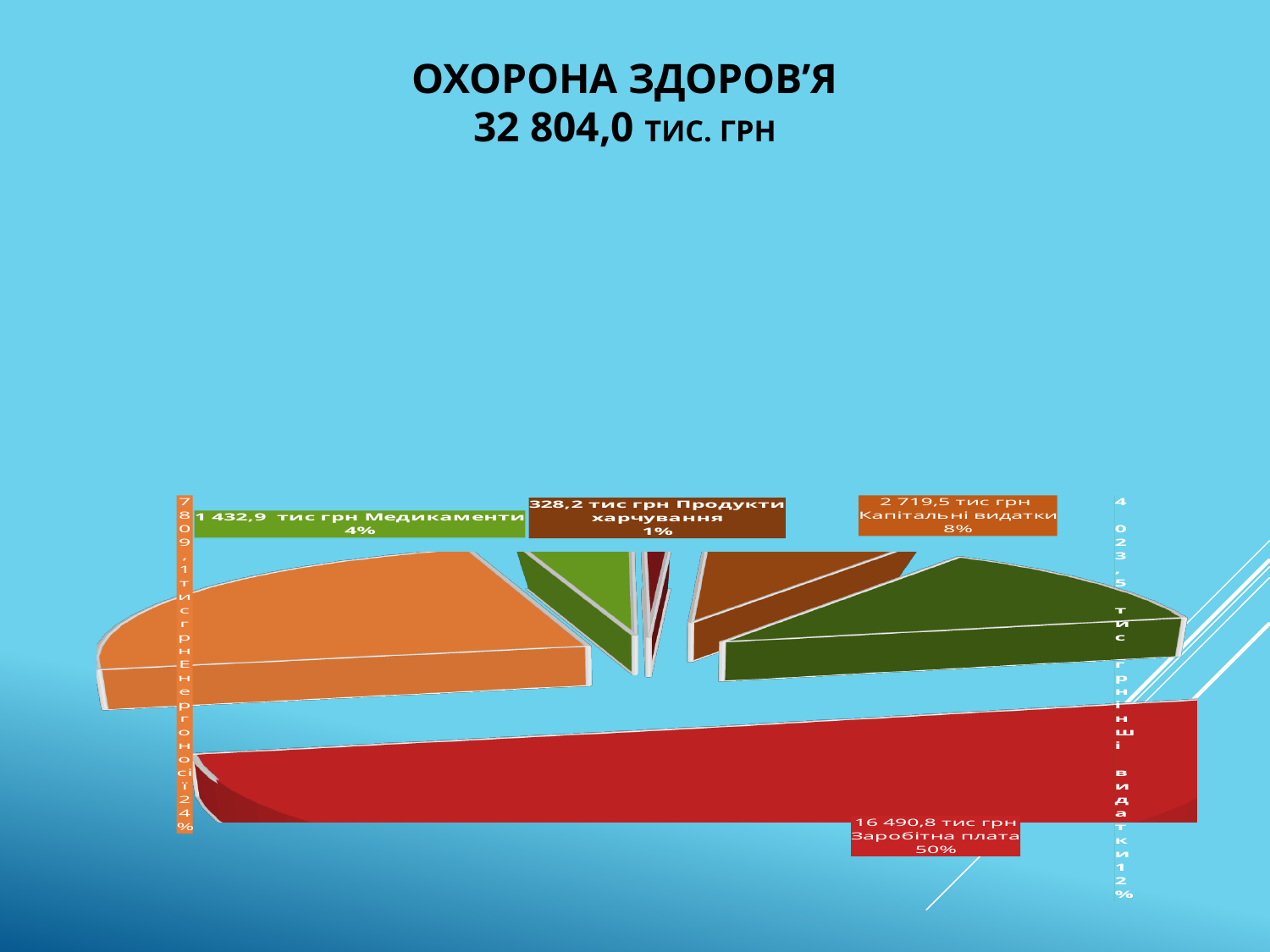
How many slices does the pie chart have? 6 What is the value for Енергоносії? 7 809,1 тис грн What kind of chart is shown on the slide? pie chart Which is larger, Капітальні видатки or Медикаменти? Капітальні видатки What is the value for Капітальні видатки? 2 719,5 тис грн What share of the pie does Медикаменти represent? 4% Which category has the smallest value? Продукти харчування What is the difference between the values for Заробітна плата and Енергоносії? 8 681,7 тис грн What is the title of the chart? ОХОРОНА ЗДОРОВ'Я 32 804,0 тис. грн What share of the pie does Інші видатки represent? 12% What is the value for Заробітна плата? 16 490,8 тис грн Which category has the largest value? Заробітна плата